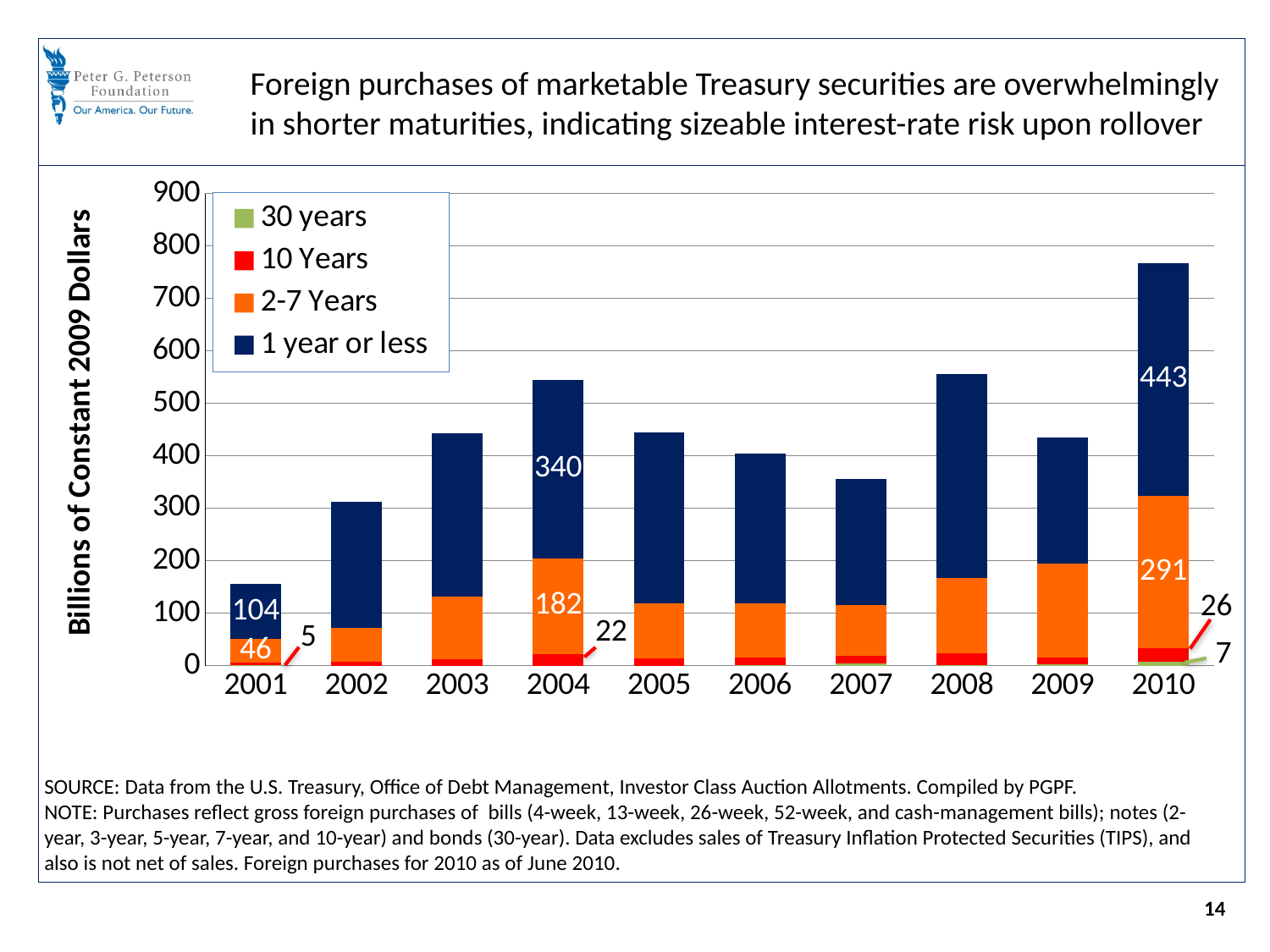
Which year has the larger '2-7 Years' value, 2004 or 2010? 2010 What is the value for the '30 years' series in 2010? 7 How many years are shown on the x axis? 10 What is the value for the '10 Years' series in 2001? 5 What is the value for the '1 year or less' series in 2010? 443 What is the total of the stacked bar for 2010? 767 Which year has the shortest stacked bar overall? 2001 Is the total height of the 2008 bar greater or less than 500? greater Which year has the tallest stacked bar overall? 2010 What is the value for the '2-7 Years' series in 2004? 182 How many series does the legend list? 4 What is the difference between the '1 year or less' values in 2010 and 2004? 103